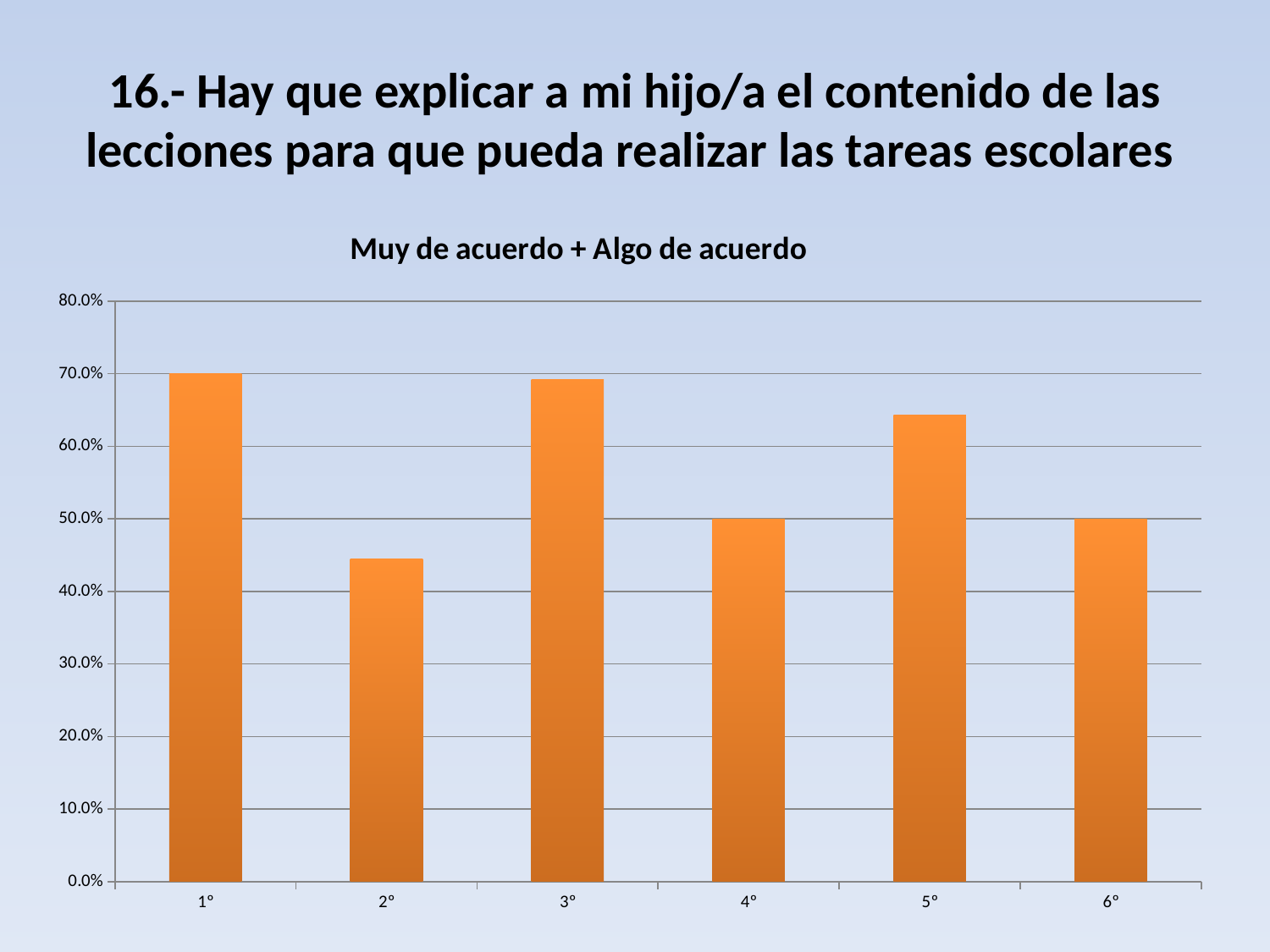
Is the value for 3° greater or less than 60.0%? greater What is the title of the chart? Muy de acuerdo + Algo de acuerdo What kind of chart is shown on the slide? bar chart Which is larger, the value for 4° or the value for 3°? 3° What colour are the bars in the chart? orange Is the value for 2° greater or less than 40.0%? greater Which category has the lowest value in the chart? 2° Which is larger, the value for 2° or the value for 5°? 5° Is the value for 2° greater or less than 50.0%? less How many categories are plotted on the x axis of the chart? 6 What is the value for 4° in the chart? 50.0%